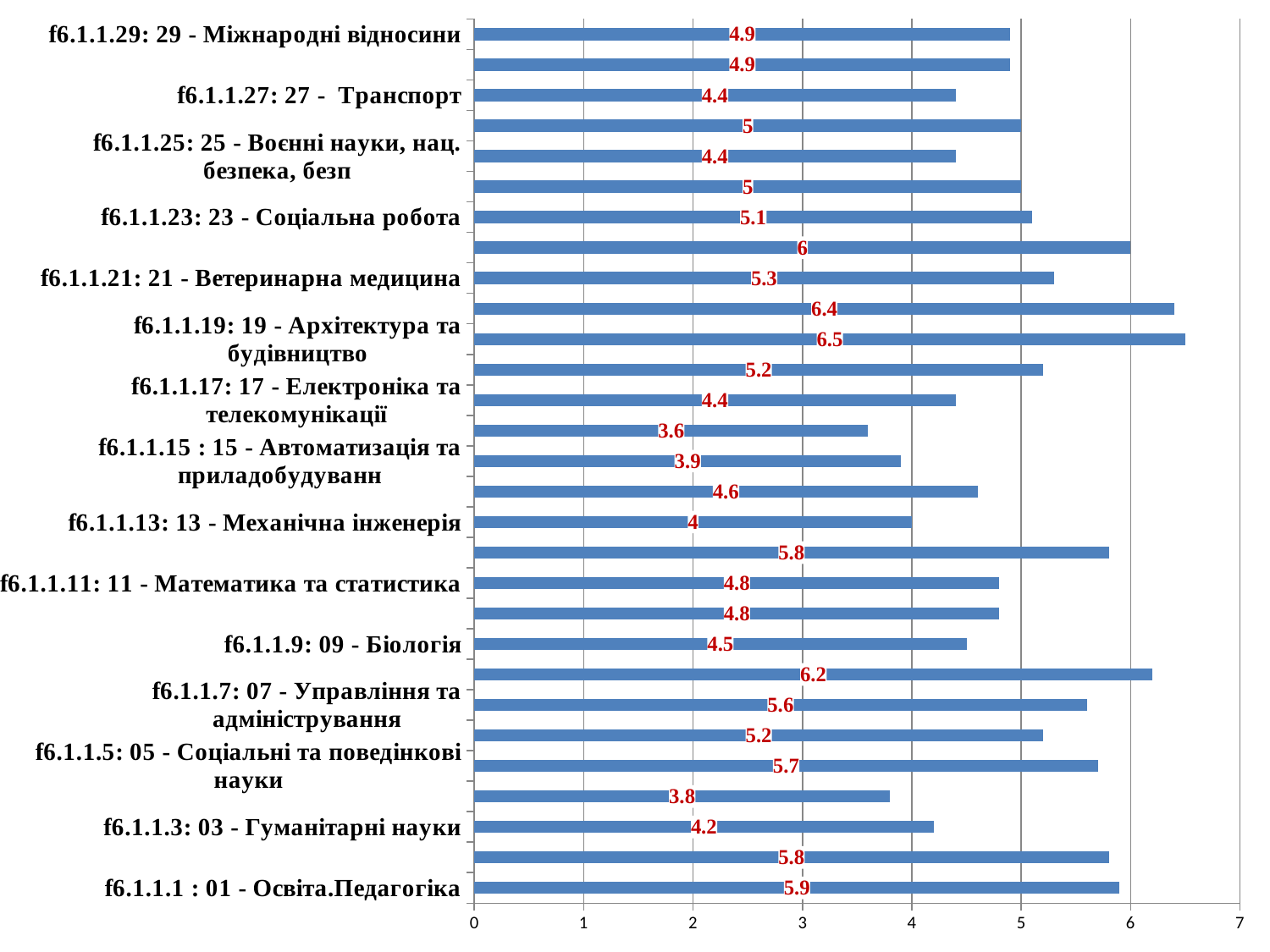
What is the value for f6.1.1.1 : 01 - Освіта.Педагогіка? 5.9 Which labeled category has the highest value on the chart? f6.1.1.19: 19 - Архітектура та будівництво Is the value for f6.1.1.13: 13 - Механічна інженерія greater or less than 5? less What is the difference between the values for 01 - Освіта.Педагогіка and 03 - Гуманітарні науки? 1.7 How many bars are plotted on the chart? 29 What is the value for f6.1.1.3: 03 - Гуманітарні науки? 4.2 What is the value for f6.1.1.21: 21 - Ветеринарна медицина? 5.3 What type of chart is shown on the slide? bar chart What is the smallest value labeled on any bar in the chart? 3.6 What is the value for f6.1.1.19: 19 - Архітектура та будівництво? 6.5 Which has a larger value: 09 - Біологія or 23 - Соціальна робота? 23 - Соціальна робота What is the value for f6.1.1.11: 11 - Математика та статистика? 4.8